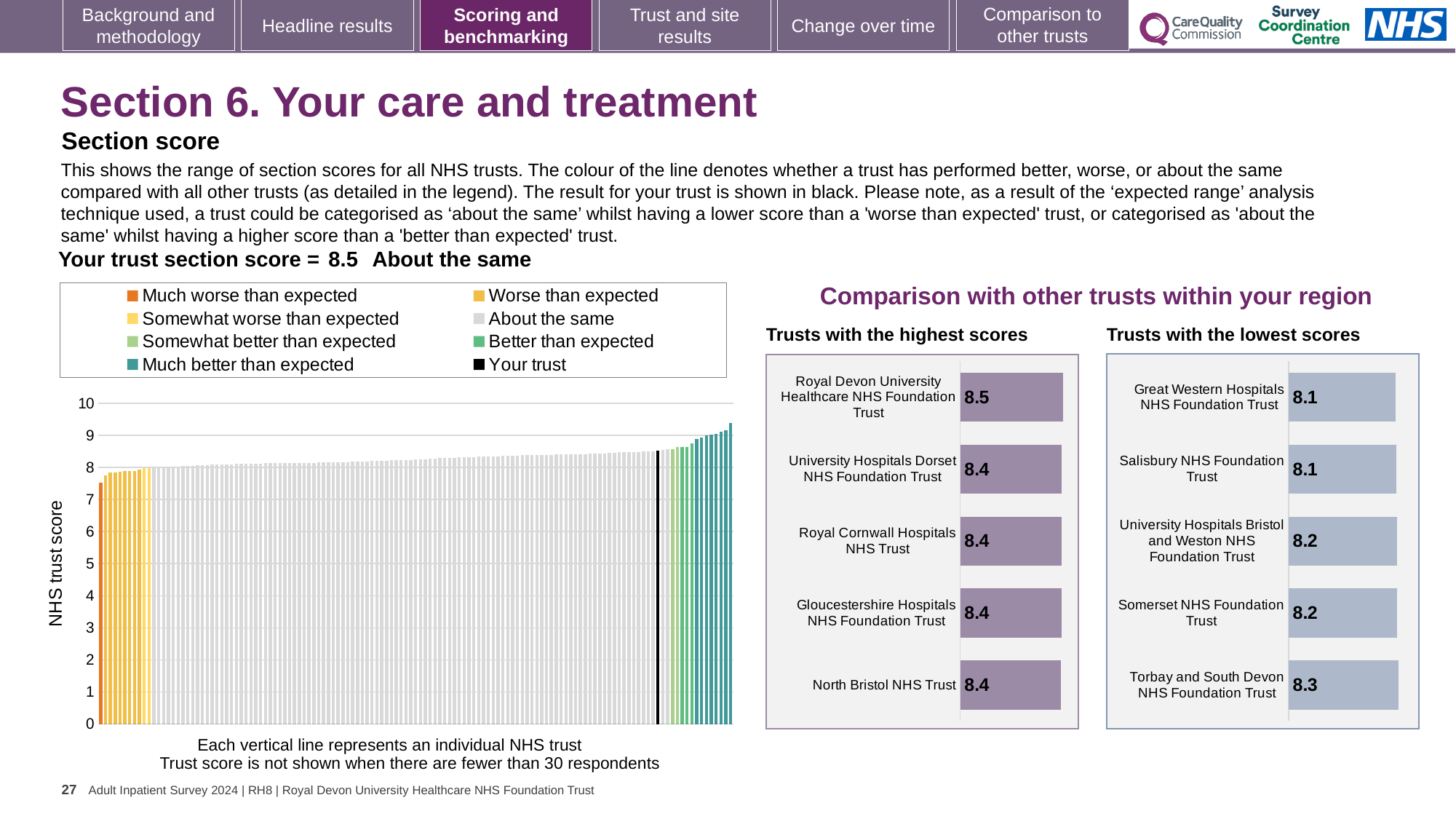
In the 'Trusts with the highest scores' chart, which trust has the highest score? Royal Devon University Healthcare NHS Foundation Trust In the 'Trusts with the lowest scores' chart, which trust has the highest score shown? Torbay and South Devon NHS Foundation Trust In the 'Trusts with the lowest scores' chart, what is the score for Great Western Hospitals NHS Foundation Trust? 8.1 In the large chart on the left, do the trust scores rise or fall from left to right along the x axis? Rise What kind of chart is the large chart on the left showing NHS trust scores? Bar chart What is the difference between the score for Royal Devon University Healthcare NHS Foundation Trust in the highest scores chart and the score for Great Western Hospitals NHS Foundation Trust in the lowest scores chart? 0.4 In the 'Trusts with the highest scores' chart, what is the score for Royal Devon University Healthcare NHS Foundation Trust? 8.5 How many entries does the legend of the large chart on the left list? 8 Which is larger: the score for Somerset NHS Foundation Trust in the lowest scores chart or the score for University Hospitals Dorset NHS Foundation Trust in the highest scores chart? University Hospitals Dorset NHS Foundation Trust In the 'Trusts with the lowest scores' chart, what is the score for Torbay and South Devon NHS Foundation Trust? 8.3 How many trusts are listed in the 'Trusts with the lowest scores' chart? 5 In the 'Trusts with the highest scores' chart, what is the score for North Bristol NHS Trust? 8.4